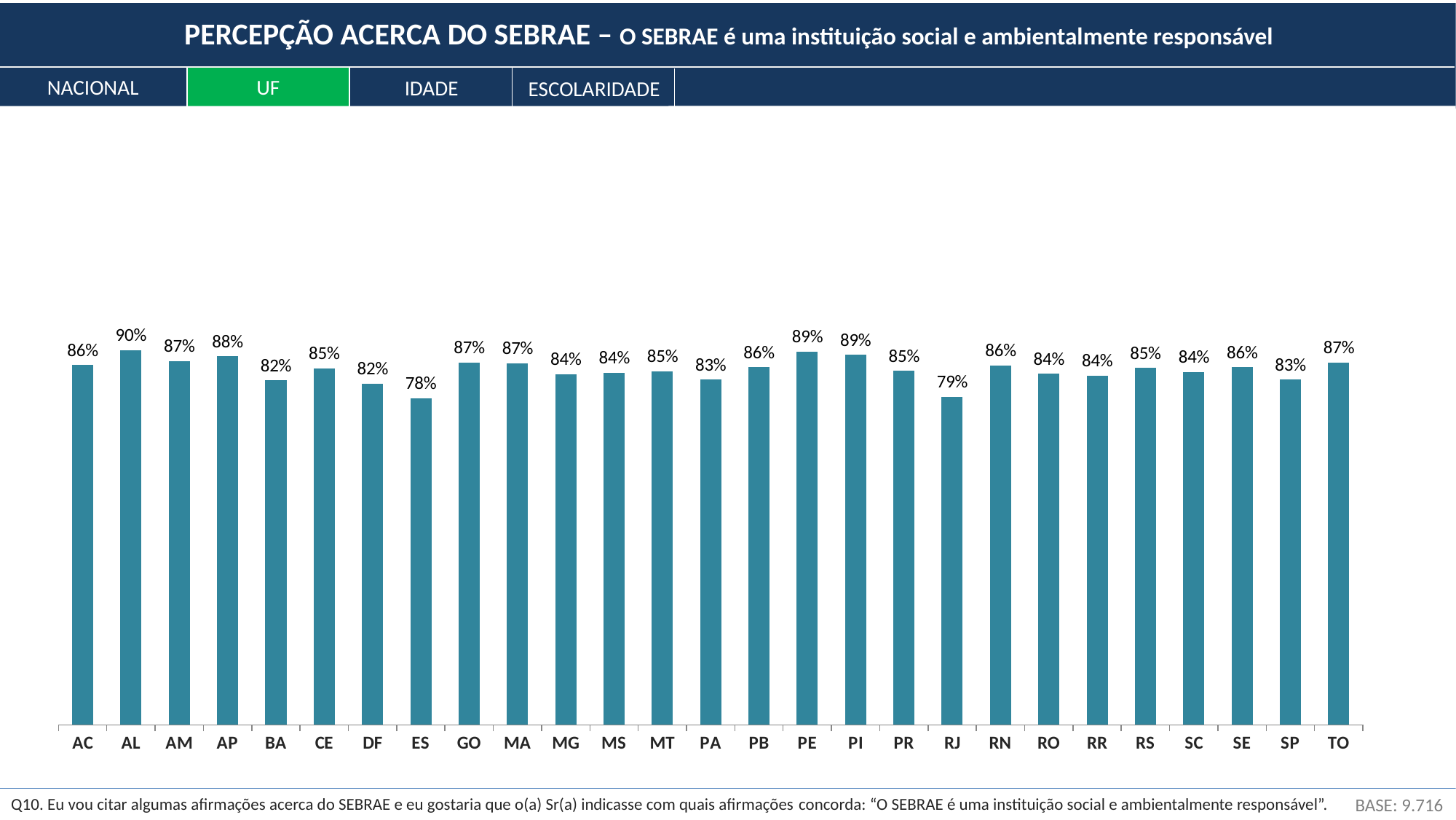
Which tab is highlighted in green above the chart? UF What is the difference between the values for AL and ES? 12% What is the value for PE? 89% What kind of chart is shown on the slide? Bar chart Which is larger, the value for PI or the value for RJ? PI What is the value for RJ? 79% What is the difference between the values for AP and BA? 6% Which UF has the lowest value? ES How many UFs are shown on the chart? 27 Which UF has the highest value? AL What is the value for AL? 90% What is the value for ES? 78%